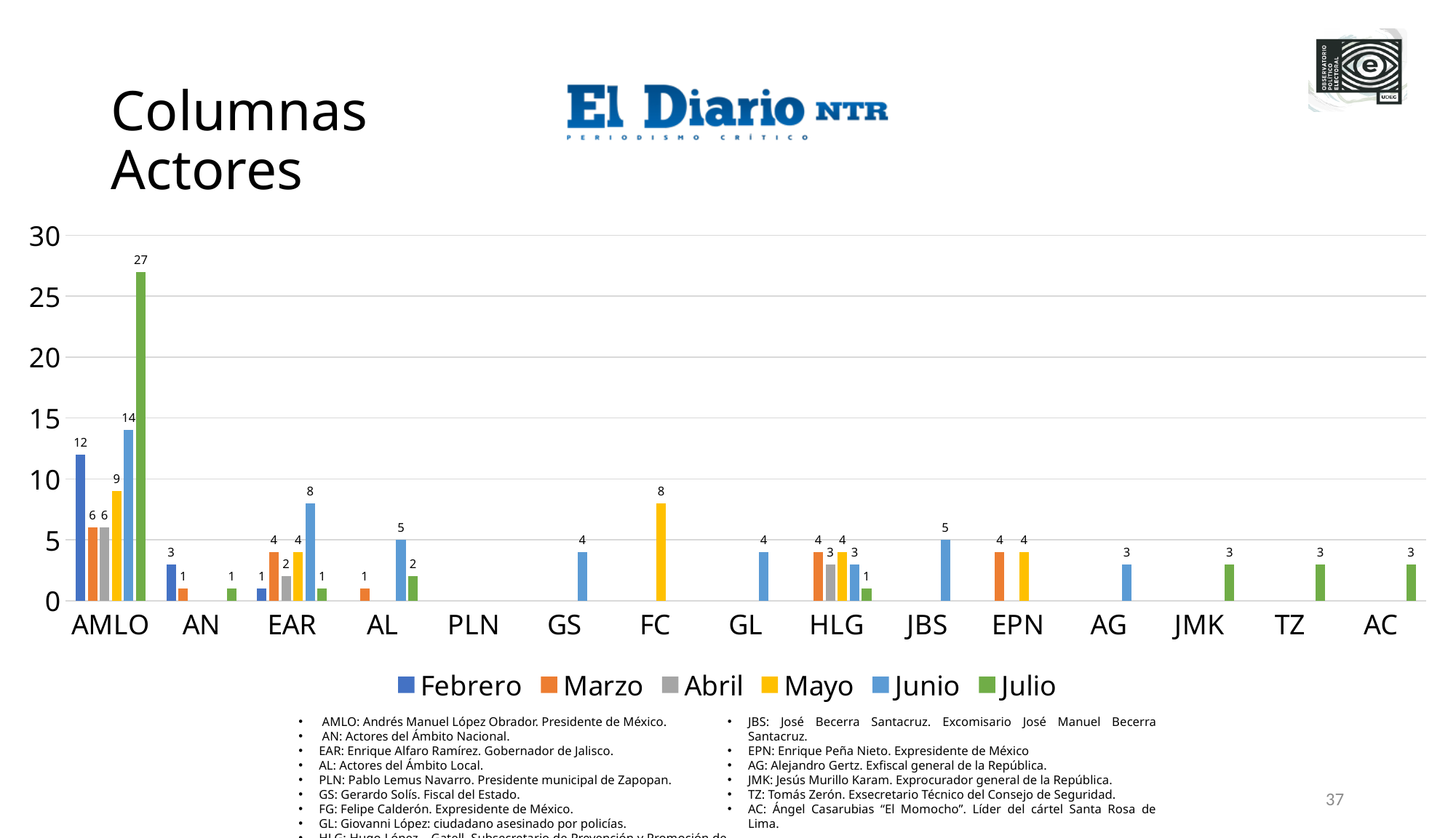
Which month has the lowest value for EAR? Febrero and Julio (both 1) Which is larger, the Junio value for AL or the Junio value for GS? Junio value for AL Which month has the highest value for AMLO? Julio What is the Junio value for EAR? 8 What is the difference between the Junio and Febrero values for AMLO? 2 What kind of chart is shown on the slide? bar chart Is the Julio value for AMLO greater or less than 25? greater What is the Julio value for AMLO? 27 Which colour represents Junio in the legend? light blue How many categories are shown on the x axis? 15 How many series does the legend list? 6 What is the Mayo value for FC? 8